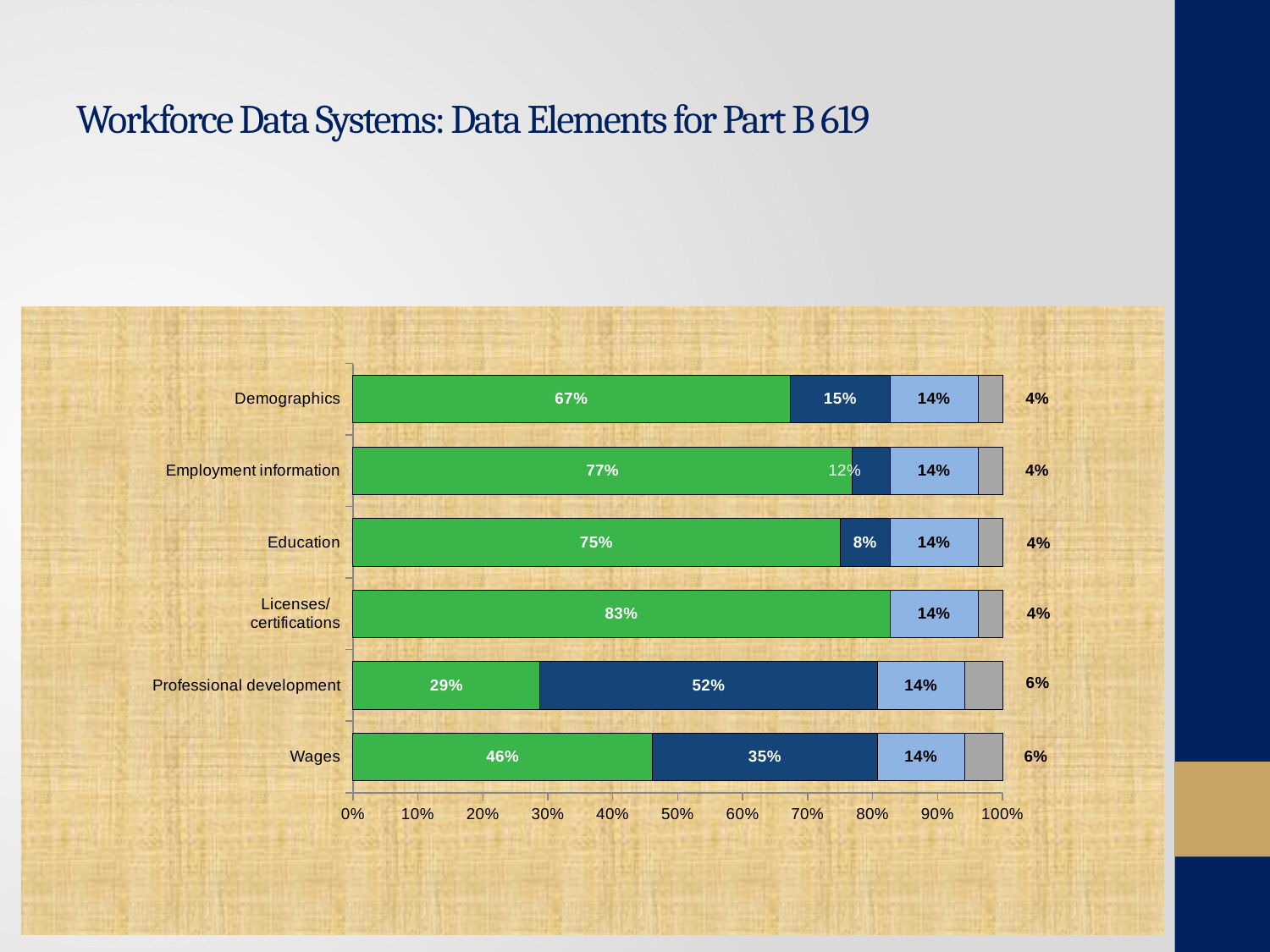
What is the value printed at the right end of the Professional development bar? 6% How many categories are plotted on the chart? 6 Which category has the smallest green segment? Professional development What is the value of the dark blue segment for Education? 8% Which has the larger dark blue segment, Professional development or Wages? Professional development What is the value of the dark blue segment for Wages? 35% What is the title of the slide? Workforce Data Systems: Data Elements for Part B 619 What kind of chart is shown on the slide? Stacked bar chart What is the value of the green segment for Demographics? 67% For Wages, what is the difference between the green segment and the dark blue segment? 11 percentage points Is the green segment for Education greater or less than 70%? greater Which category has the largest green segment? Licenses/certifications